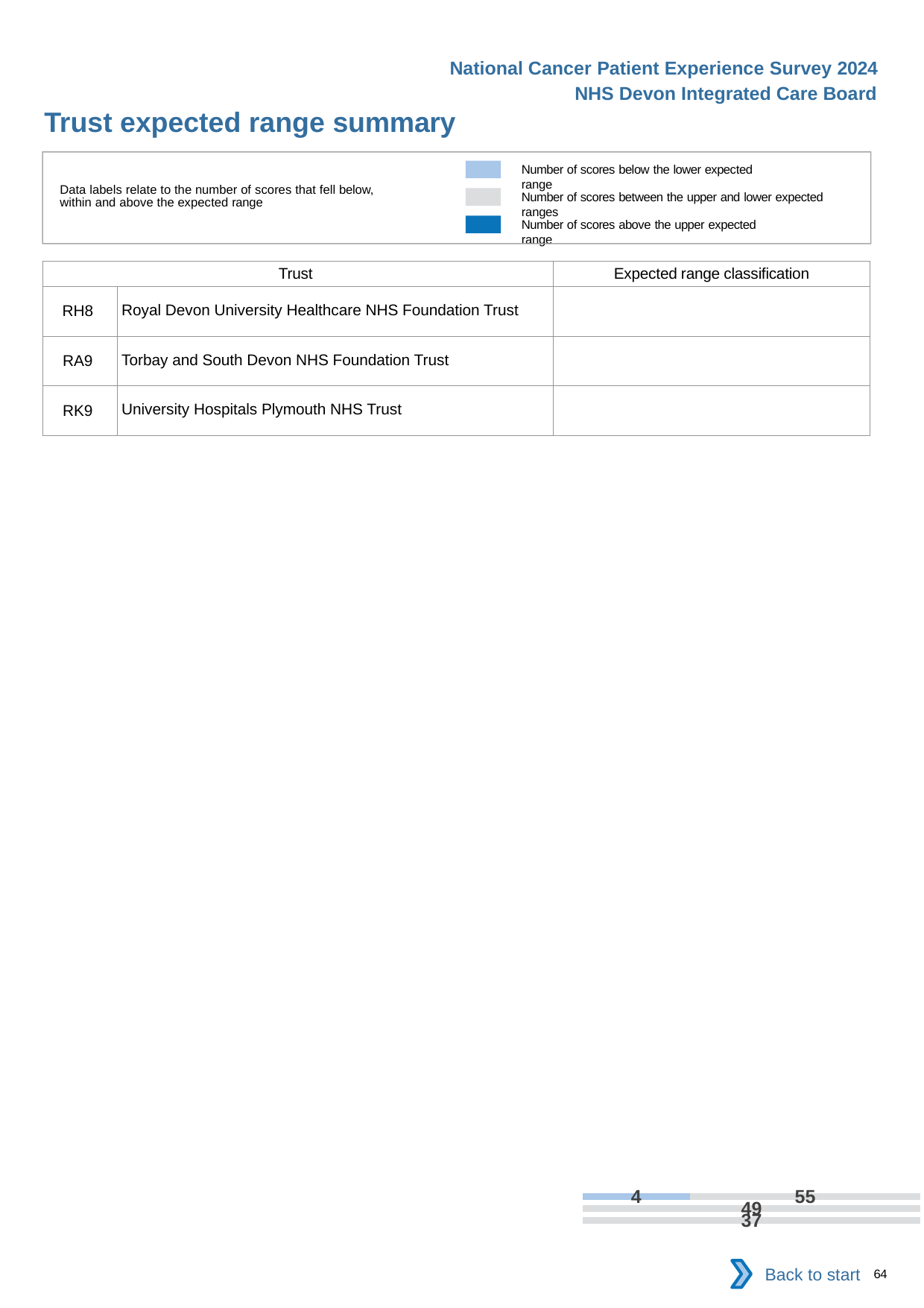
According to the legend, what does the light blue colour represent? Number of scores below the lower expected range What is the total of the topmost bar (light blue segment plus grey segment)? 59 What is the difference between the grey segment (55) and the light blue segment (4) in the topmost bar? 51 What value is labelled on the grey segment of the topmost bar? 55 What value is labelled on the light blue segment of the topmost bar? 4 How many series does the legend list for the chart? 3 How many bars are plotted in the chart at the bottom of the slide? 3 What kind of chart is shown at the bottom of the slide? bar chart According to the legend, what does the dark blue colour represent? Number of scores above the upper expected range In the topmost bar, which segment is larger: the light blue segment or the grey segment? grey segment